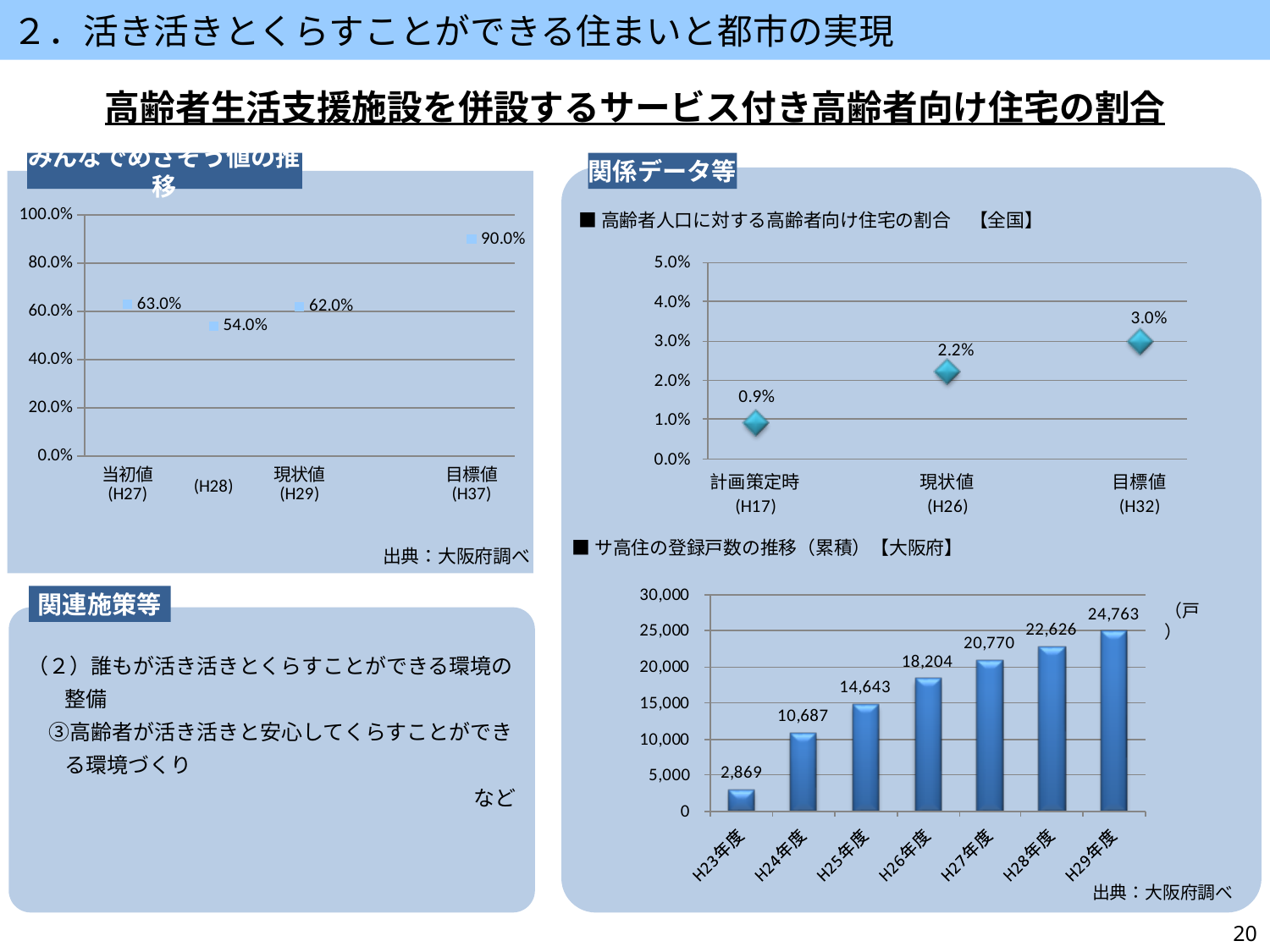
In the top-right chart 「高齢者人口に対する高齢者向け住宅の割合【全国】」, what is the difference between 目標値 (H32) and 計画策定時 (H17)? 2.1% In the bottom-right chart 「サ高住の登録戸数の推移（累積）【大阪府】」, how many years are shown? 7 In the bottom-right chart 「サ高住の登録戸数の推移（累積）【大阪府】」, do the values rise or fall from H23年度 to H29年度? rise In the bottom-right chart 「サ高住の登録戸数の推移（累積）【大阪府】」, what is the difference between H29年度 and H28年度? 2,137 In the top-left chart 「みんなでめざそう値の推移」, what is the value for 目標値 (H37)? 90.0% In the bottom-right chart 「サ高住の登録戸数の推移（累積）【大阪府】」, what is the value for H23年度? 2,869 In the top-left chart 「みんなでめざそう値の推移」, which is larger, the value for 当初値 (H27) or 現状値 (H29)? 当初値 (H27) In the top-left chart 「みんなでめざそう値の推移」, which point has the lowest value? H28 In the bottom-right chart 「サ高住の登録戸数の推移（累積）【大阪府】」, what is the value for H29年度? 24,763 In the bottom-right chart 「サ高住の登録戸数の推移（累積）【大阪府】」, which year has the lowest value? H23年度 In the top-right chart 「高齢者人口に対する高齢者向け住宅の割合【全国】」, what is the value for 現状値 (H26)? 2.2% What kind of chart is the bottom-right chart 「サ高住の登録戸数の推移（累積）【大阪府】」? bar chart